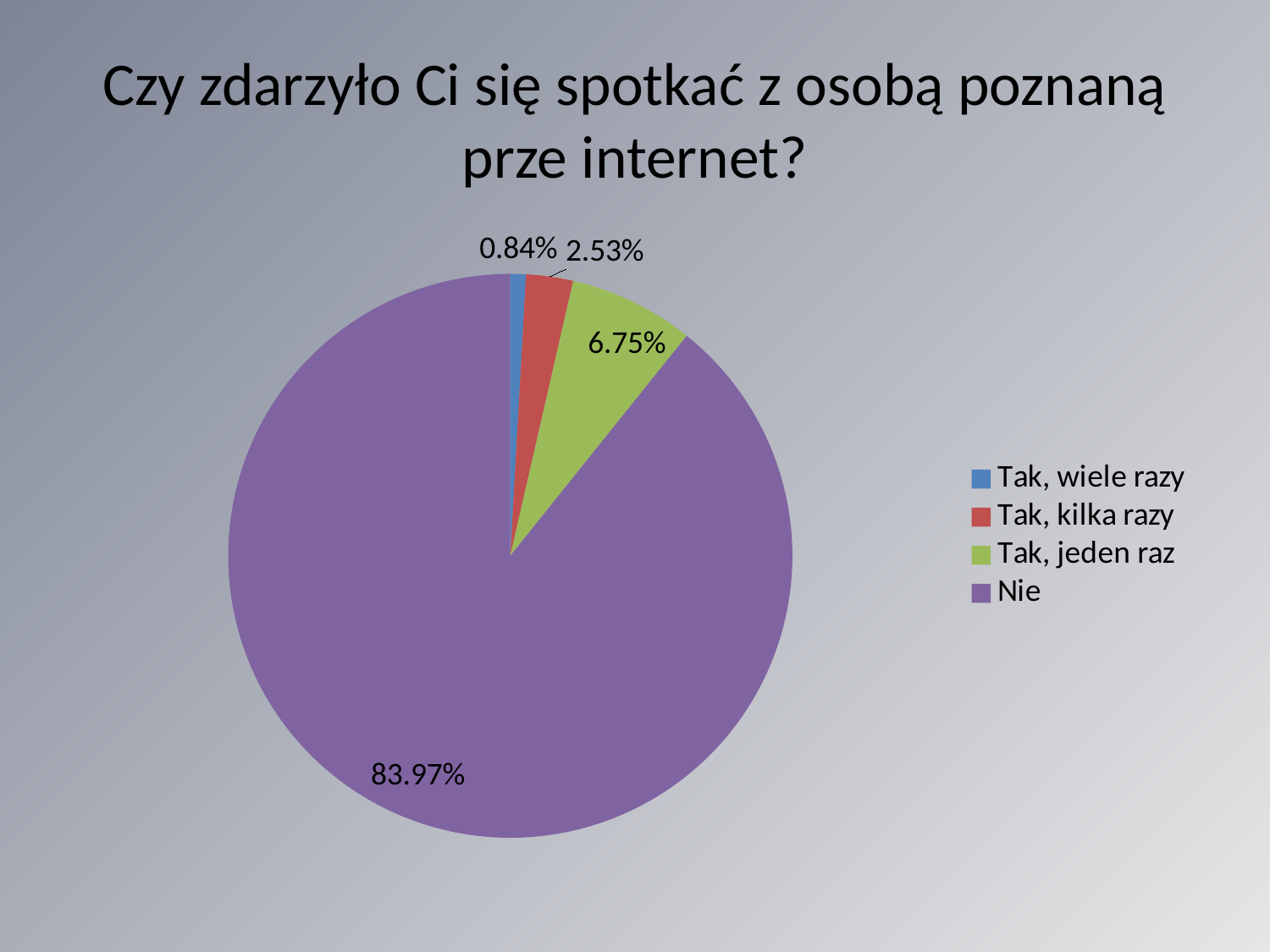
What is the difference between the share for "Tak, jeden raz" and the share for "Tak, kilka razy"? 4.22% Which category has the smallest slice of the pie? Tak, wiele razy What share of the pie does "Tak, kilka razy" have? 2.53% Which is larger: the slice for "Tak, jeden raz" or the slice for "Tak, kilka razy"? Tak, jeden raz What kind of chart is shown on the slide? pie chart What share of the pie does "Tak, jeden raz" have? 6.75% What share of the pie does "Tak, wiele razy" have? 0.84% What share of the pie does "Nie" have? 83.97% What colour is the slice for "Nie"? purple Which category has the largest slice of the pie? Nie How many slices does the pie chart have? 4 How many entries does the legend list? 4